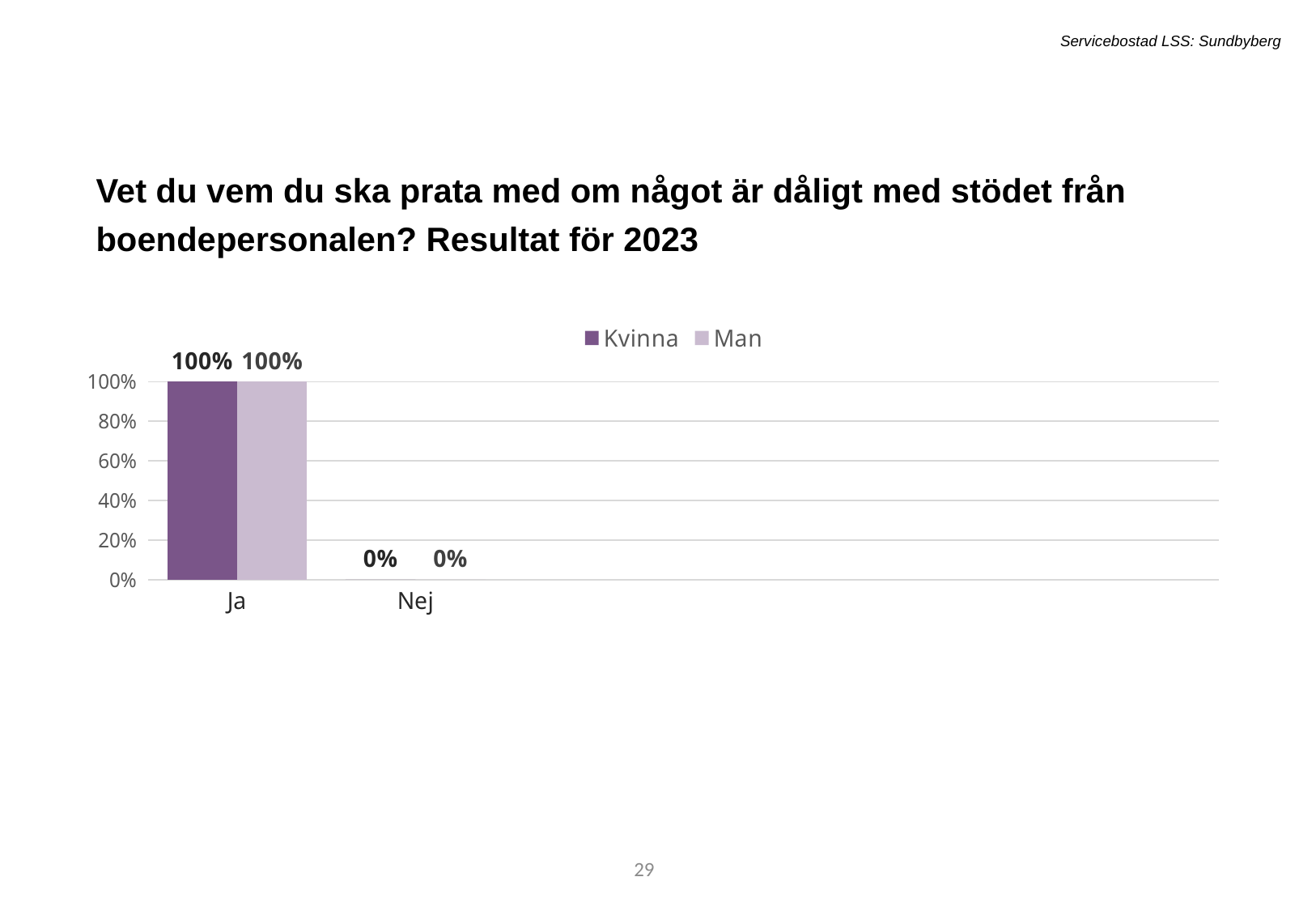
Which category has the highest value for Kvinna? Ja What is the value for Man in the Ja category? 100% What is the value for Man in the Nej category? 0% What is the value for Kvinna in the Ja category? 100% How many series does the legend list? 2 What is the difference between the Kvinna values for Ja and Nej? 100% How many categories are shown on the x axis? 2 What are the two series named in the legend? Kvinna and Man Which is larger for Man: the value for Ja or the value for Nej? Ja Which category has the lowest value for Man? Nej What is the value for Kvinna in the Nej category? 0% What kind of chart is shown on the slide? Bar chart